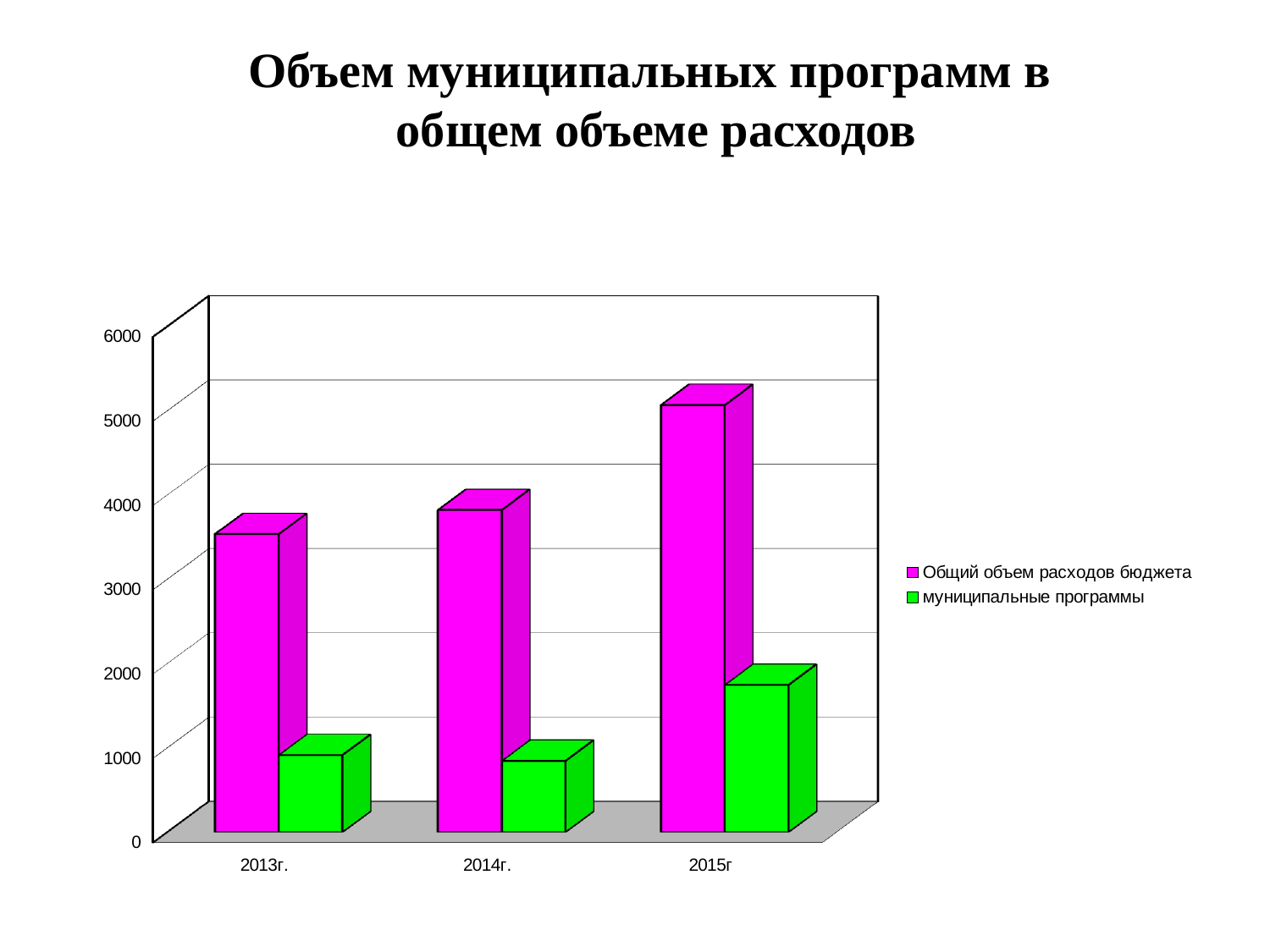
In which year is the value for Общий объем расходов бюджета highest? 2015г What is the title of the chart? Объем муниципальных программ в общем объеме расходов In which year is the value for Общий объем расходов бюджета lowest? 2013г. Is the value for Общий объем расходов бюджета in 2015г greater or less than 4000? greater What kind of chart is shown on the slide? bar chart How many categories (years) are shown on the x axis? 3 Does the value for Общий объем расходов бюджета rise or fall from 2013г. to 2015г? rise Which series is shown in green? муниципальные программы Is the value for муниципальные программы in 2013г. greater or less than 2000? less In which year is the value for муниципальные программы highest? 2015г Is the value for Общий объем расходов бюджета in 2013г. greater or less than 3000? greater How many series does the legend list? 2